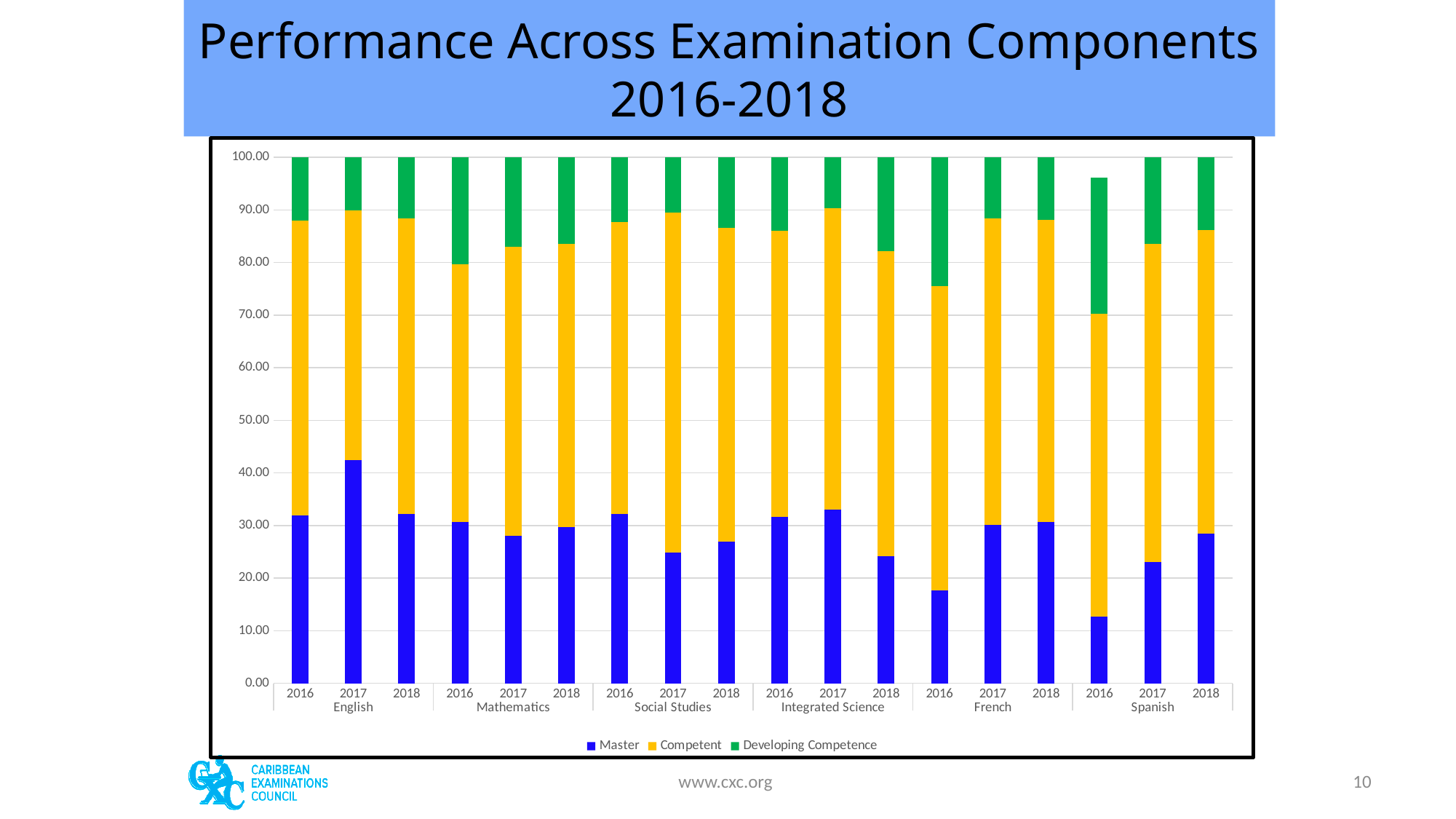
Is the Master value for Mathematics 2017 greater or less than 30? less Which bar does not reach 100.00 on the axis? Spanish 2016 What colour represents the Master series in the legend? Blue Which bar has the largest Master segment? English 2017 How many subjects are shown along the x axis? 6 How many series does the legend list? 3 Is the Master value for Spanish 2016 greater or less than 20? less How many bars are plotted in the chart? 18 Which bar has the smallest Master segment? Spanish 2016 Which has the larger Master segment, French 2016 or French 2017? French 2017 What kind of chart is shown on the slide? Stacked bar chart Is the Master value for English 2017 greater or less than 40? greater